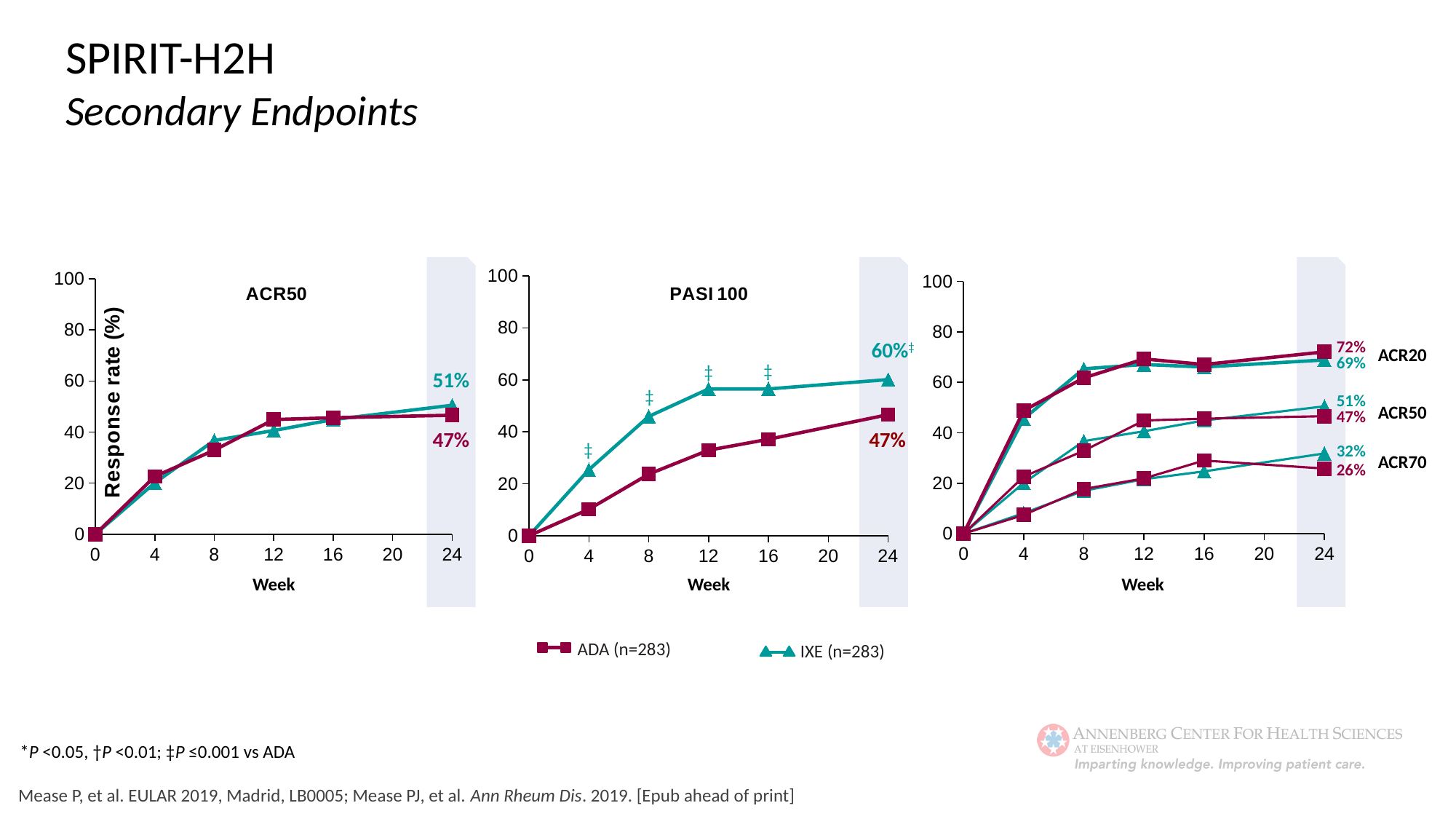
In the ACR50 chart, what is the response rate for ADA at week 24? 47% What kind of chart is the PASI 100 chart? Line chart In the PASI 100 chart, is the ADA response rate at week 4 greater or less than 20? less In the PASI 100 chart, what is the difference between the IXE and ADA response rates at week 24? 13% In the rightmost chart, which treatment has the higher ACR70 response rate at week 24, ADA or IXE? IXE In the PASI 100 chart, what is the response rate for IXE at week 24? 60% In the rightmost chart, what is the ACR70 response rate for IXE at week 24? 32% In the rightmost chart, what is the difference between the ADA and IXE ACR20 response rates at week 24? 3% In the ACR50 chart, what is the response rate for IXE at week 24? 51% In the rightmost chart, what is the ACR20 response rate for ADA at week 24? 72% In the PASI 100 chart, is the IXE response rate at week 12 greater or less than 40? greater How many series does the legend list? 2